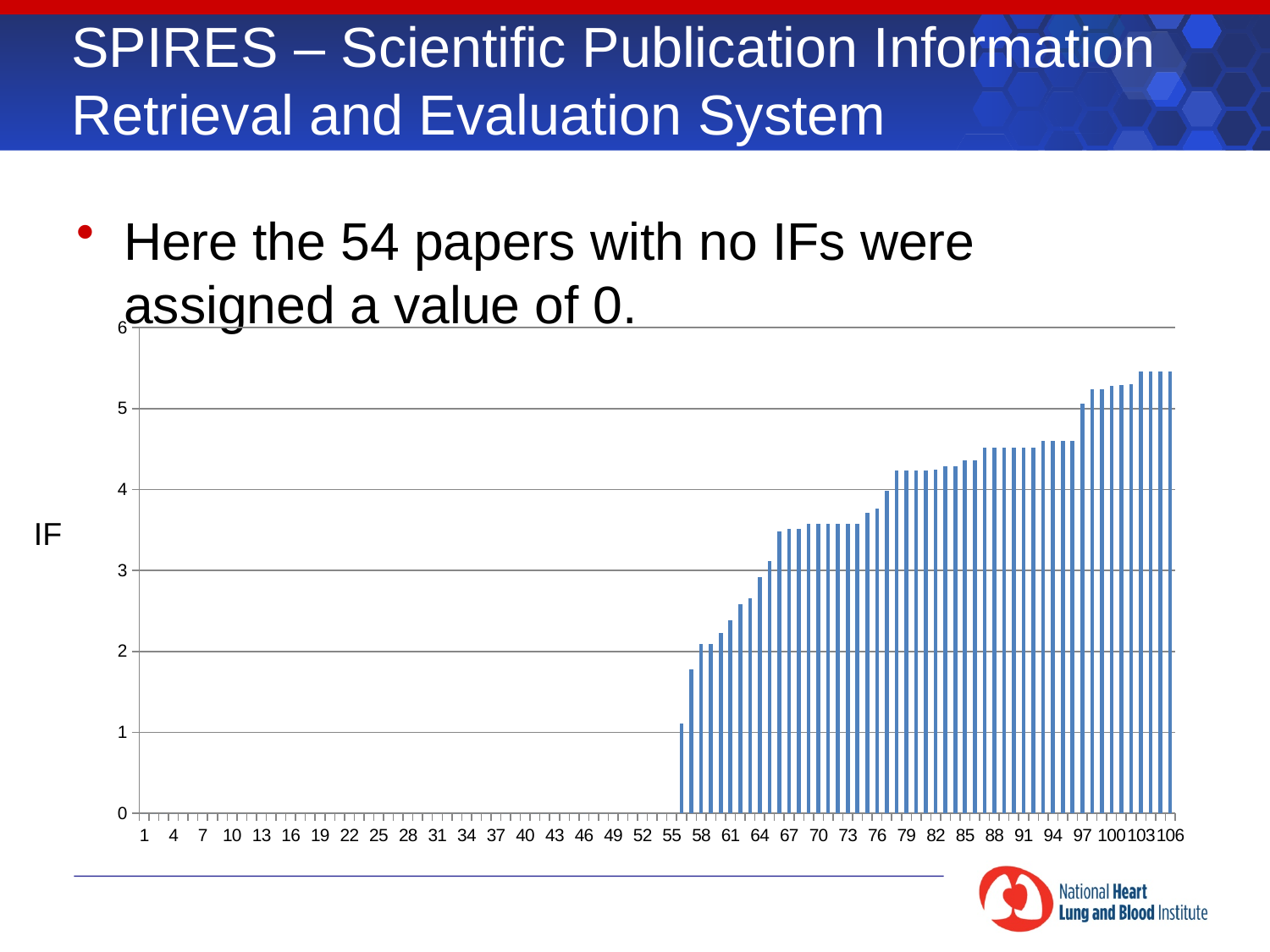
What is the highest value shown on the vertical axis of the chart? 6 Is the value for category 106 greater or less than 5? greater What kind of chart is shown on the slide? bar chart Is the value for category 10 greater or less than 1? less Which has the larger value, category 55 or category 106? 106 Is the value for category 55 greater or less than 2? less What is the last category label shown on the x axis? 106 What is the label on the vertical axis of the chart? IF Do the bar values rise or fall moving from left to right along the x axis? rise